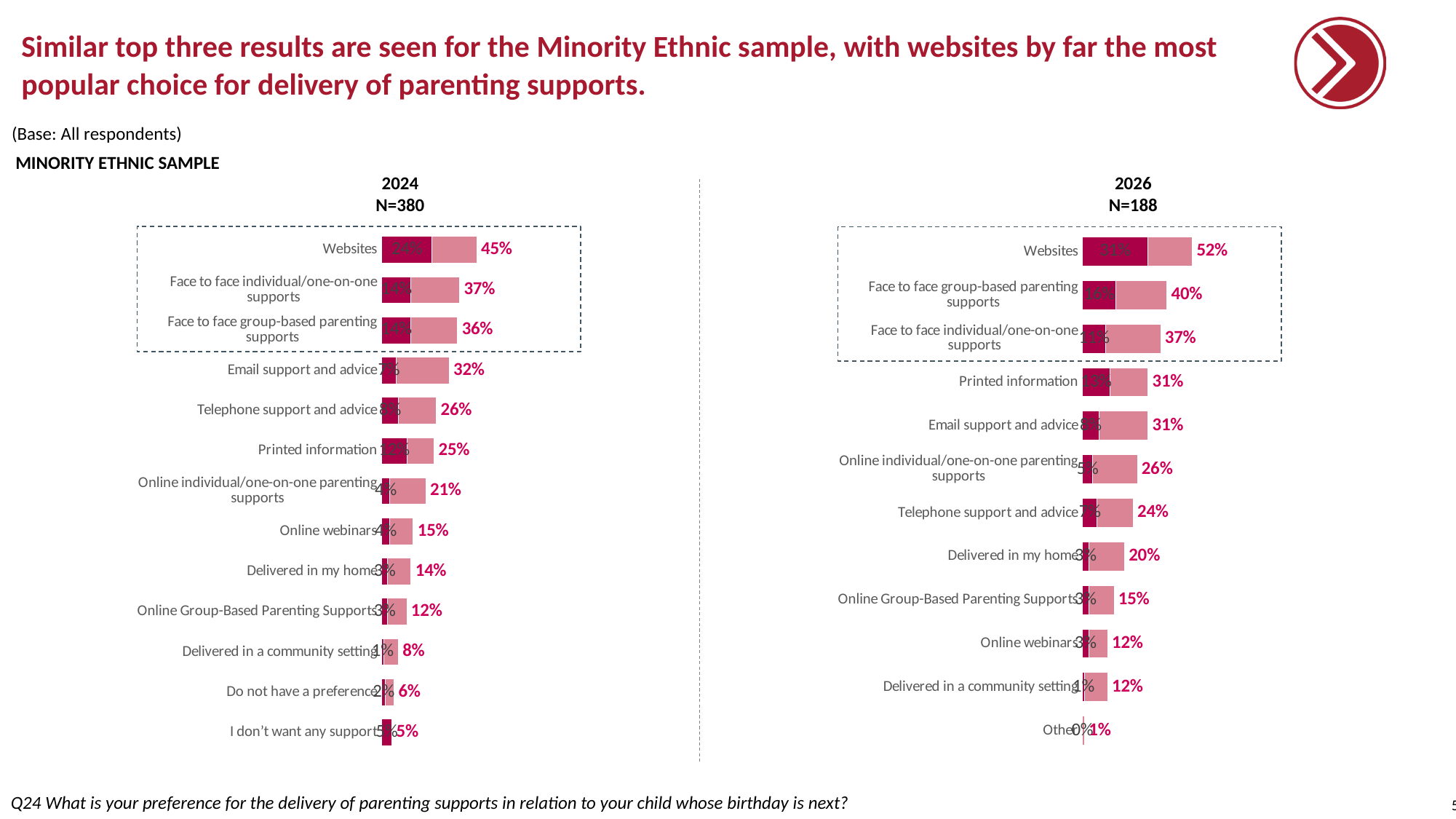
What is the difference between the overall value for Websites in the 2026 chart and in the 2024 chart? 7% In the 2026 chart, which category has the highest overall value? Websites In the 2026 chart, what is the overall value shown for Delivered in my home? 20% What type of chart is used for the 2026 data? Bar chart In the 2024 chart, which category has the lowest overall value? I don't want any support In the 2024 chart, which has a larger overall value: Telephone support and advice or Printed information? Telephone support and advice In the 2026 chart, what is the overall value shown for Websites? 52% In the 2024 chart, what is the overall value shown for Websites? 45% How many categories are shown in the 2026 chart? 12 In the 2024 chart, what is the overall value shown for Email support and advice? 32% In the 2026 chart, which category has the lowest overall value? Other How many categories are shown in the 2024 chart? 13